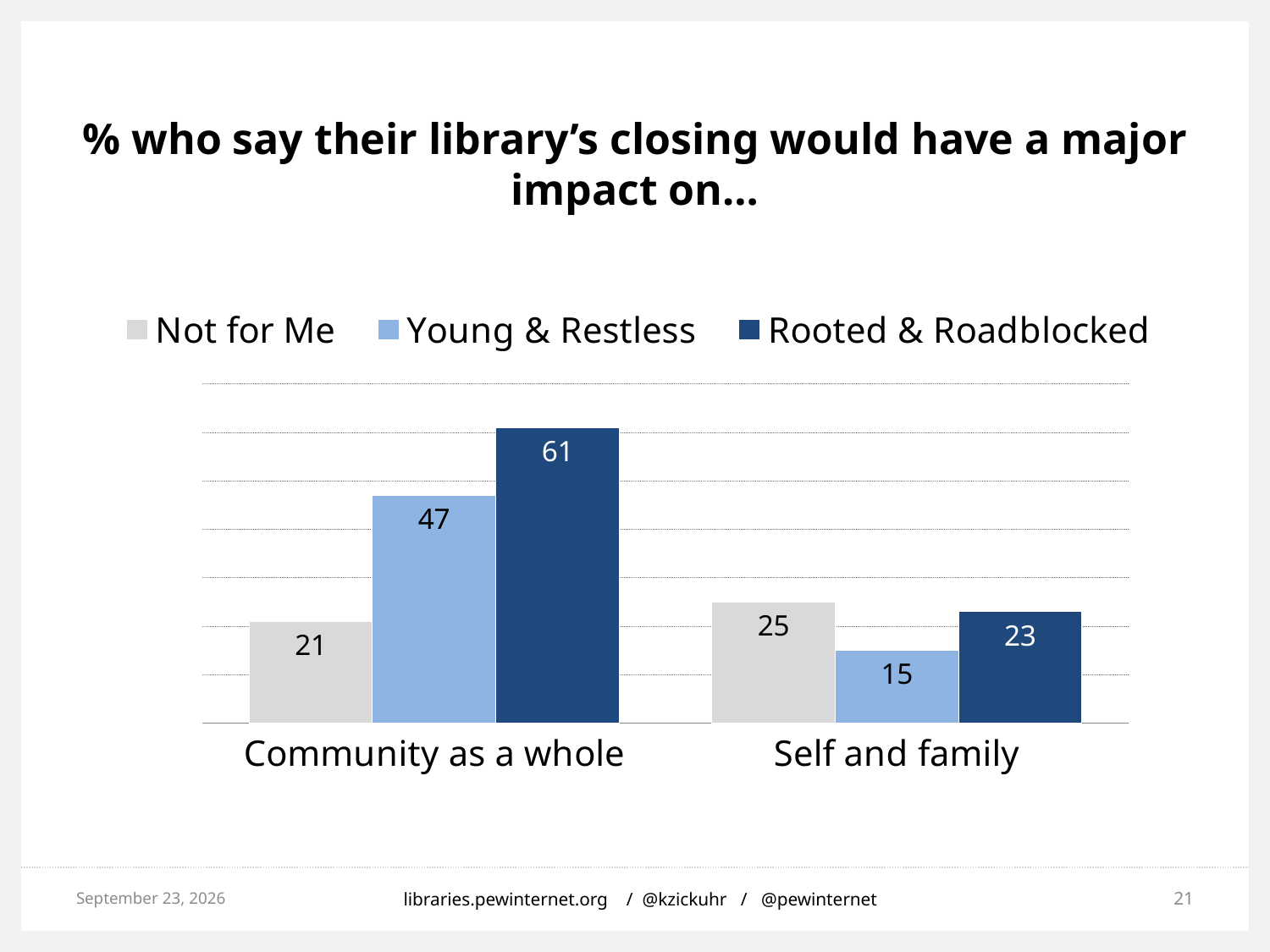
Which series has the lowest value in the Self and family category? Young & Restless What is the difference between the Not for Me and Rooted & Roadblocked values for Self and family? 2 What is the value for Young & Restless in the Self and family category? 15 What kind of chart is shown on the slide? Bar chart How many series does the legend list? 3 What is the value for Not for Me in the Community as a whole category? 21 What is the difference between the Rooted & Roadblocked and Young & Restless values for Community as a whole? 14 Which series is shown in the darkest blue colour? Rooted & Roadblocked What is the value for Rooted & Roadblocked in the Community as a whole category? 61 How many categories are shown on the x axis? 2 Which series has the highest value in the Community as a whole category? Rooted & Roadblocked Which is larger: the Not for Me value for Self and family or the Not for Me value for Community as a whole? Self and family